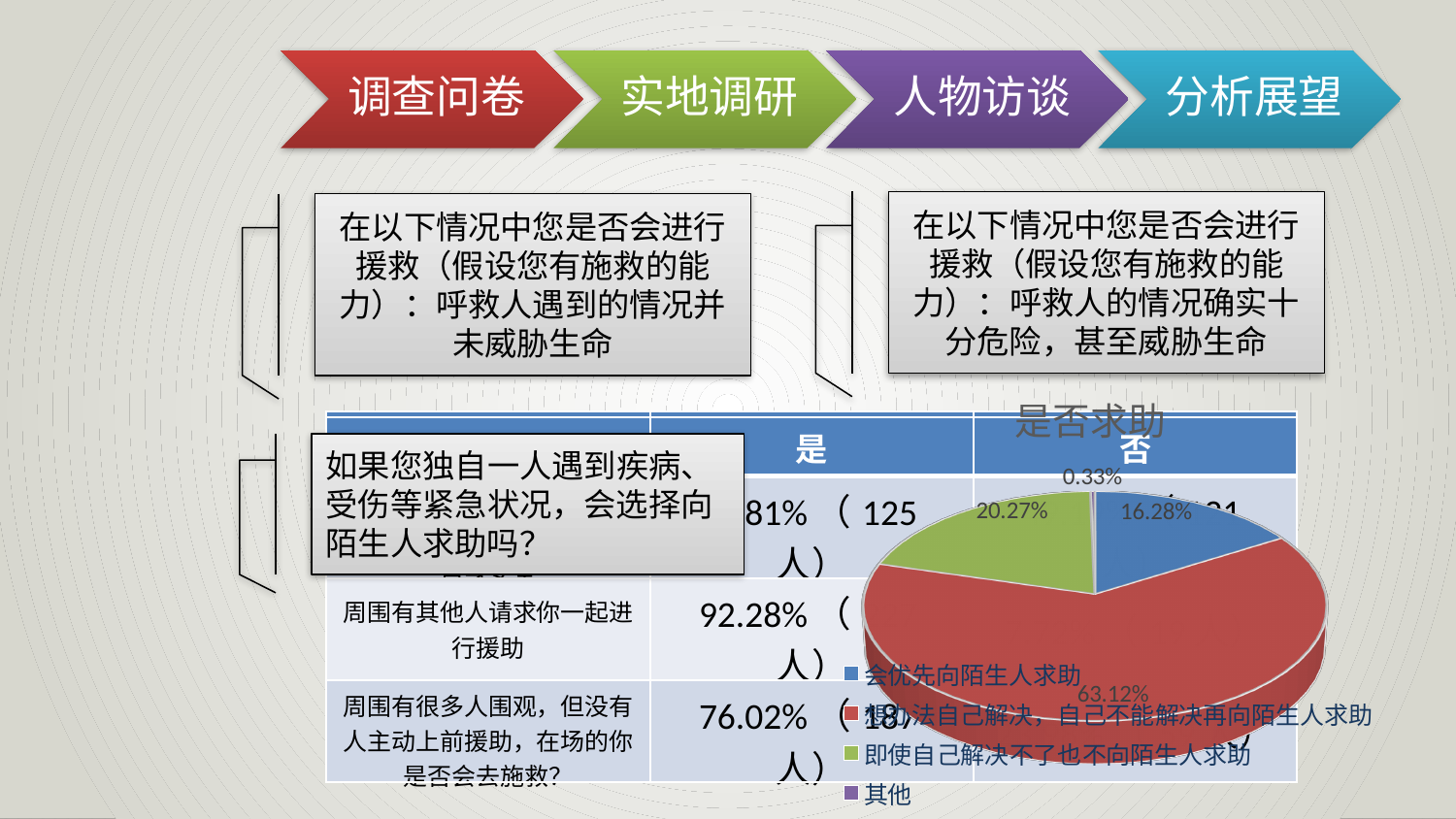
What percentage of the pie chart is 其他? 0.33% What share of the pie does 想办法自己解决，自己不能解决再向陌生人求助 take? 63.12% How many entries does the pie chart's legend list? 4 What is the title of the pie chart? 是否求助 What kind of chart is shown on the slide? pie chart Which category has the smallest share in the pie chart? 其他 How many slices does the pie chart have? 4 What is the difference in percentage points between 想办法自己解决，自己不能解决再向陌生人求助 and 即使自己解决不了也不向陌生人求助? 42.85% What percentage of the pie chart is 即使自己解决不了也不向陌生人求助? 20.27% What percentage of the pie chart is 会优先向陌生人求助? 16.28% Which category has the largest share in the pie chart? 想办法自己解决，自己不能解决再向陌生人求助 Which is larger in the pie chart: 即使自己解决不了也不向陌生人求助 or 会优先向陌生人求助? 即使自己解决不了也不向陌生人求助